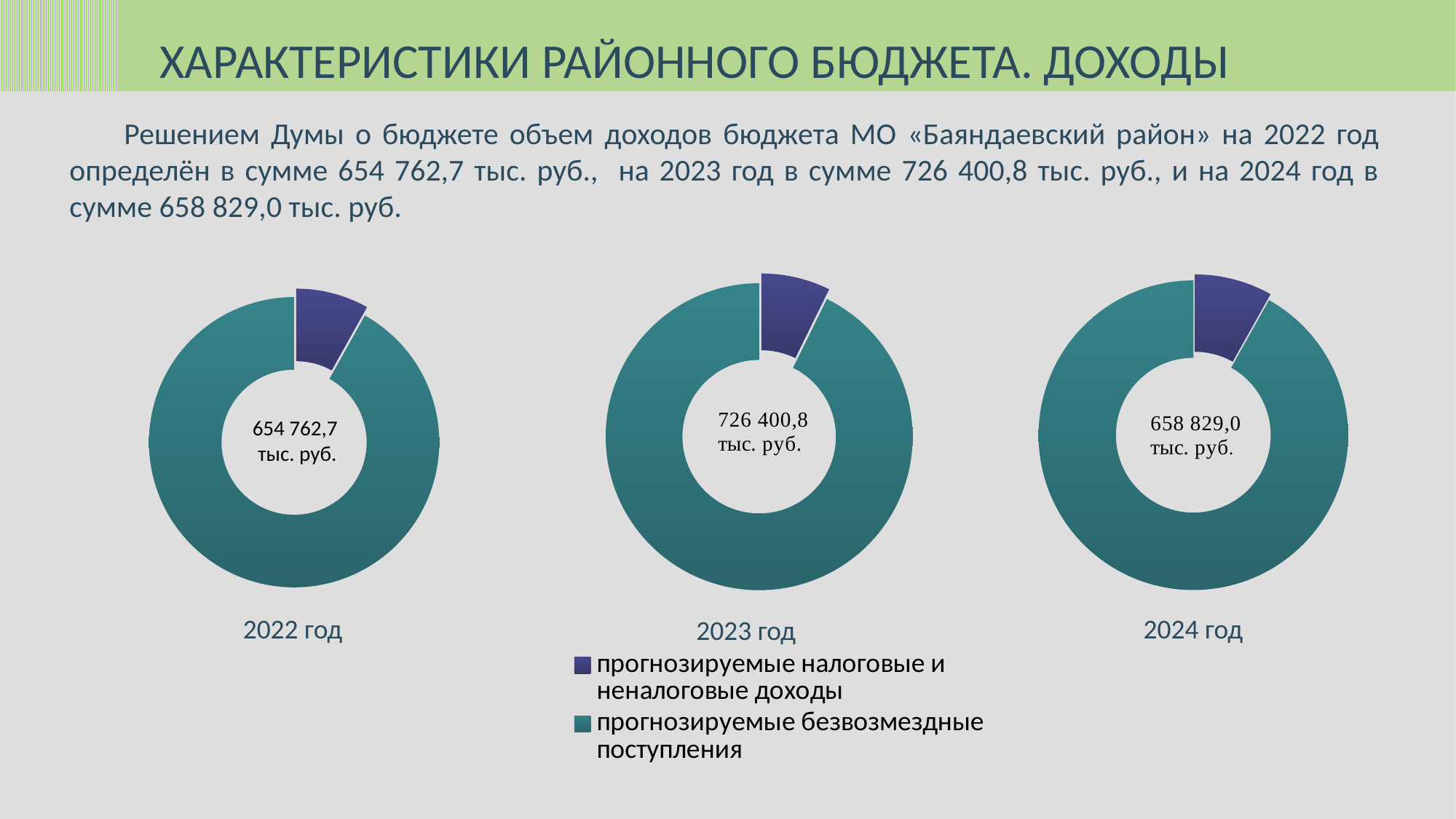
What is the difference between the total shown in the 2023 год chart and the total shown in the 2022 год chart? 71 638,1 тыс. руб. What kind of chart is used for the 2022 год chart? doughnut chart Which legend entry is shown in dark blue/purple? прогнозируемые налоговые и неналоговые доходы Which legend entry is shown in teal? прогнозируемые безвозмездные поступления In the 2022 год chart, what total value is printed in the centre? 654 762,7 тыс. руб. Which year's chart shows the lowest total budget income? 2022 год How many doughnut charts are shown on the slide? 3 In the 2023 год chart, what total value is printed in the centre? 726 400,8 тыс. руб. How many series does the legend list? 2 In the 2024 год chart, what total value is printed in the centre? 658 829,0 тыс. руб. In the 2024 год chart, which slice is larger: прогнозируемые налоговые и неналоговые доходы or прогнозируемые безвозмездные поступления? прогнозируемые безвозмездные поступления Which year's chart shows the highest total budget income? 2023 год